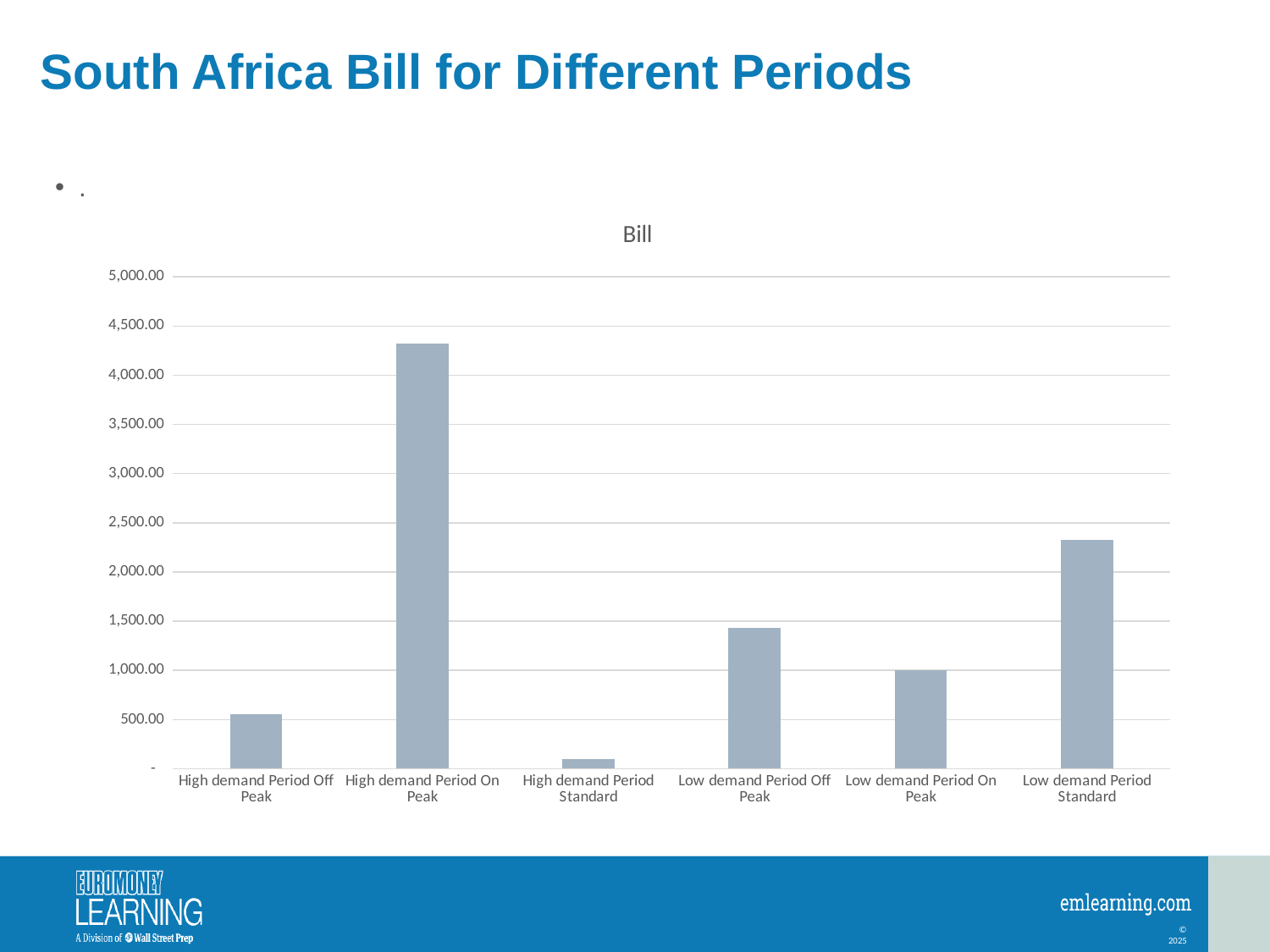
What is the title of the chart? Bill Which is larger, the bill for Low demand Period Standard or Low demand Period Off Peak? Low demand Period Standard How many categories are plotted in the Bill chart? 6 Is the value for Low demand Period Standard greater or less than 2,500.00? less Which is larger, the bill for High demand Period Off Peak or Low demand Period On Peak? Low demand Period On Peak Is the value for High demand Period Off Peak greater or less than 1,000.00? less What kind of chart is shown on the slide? bar chart Is the value for Low demand Period Off Peak greater or less than 1,000.00? greater Which category has the highest bill? High demand Period On Peak Which category has the lowest bill? High demand Period Standard